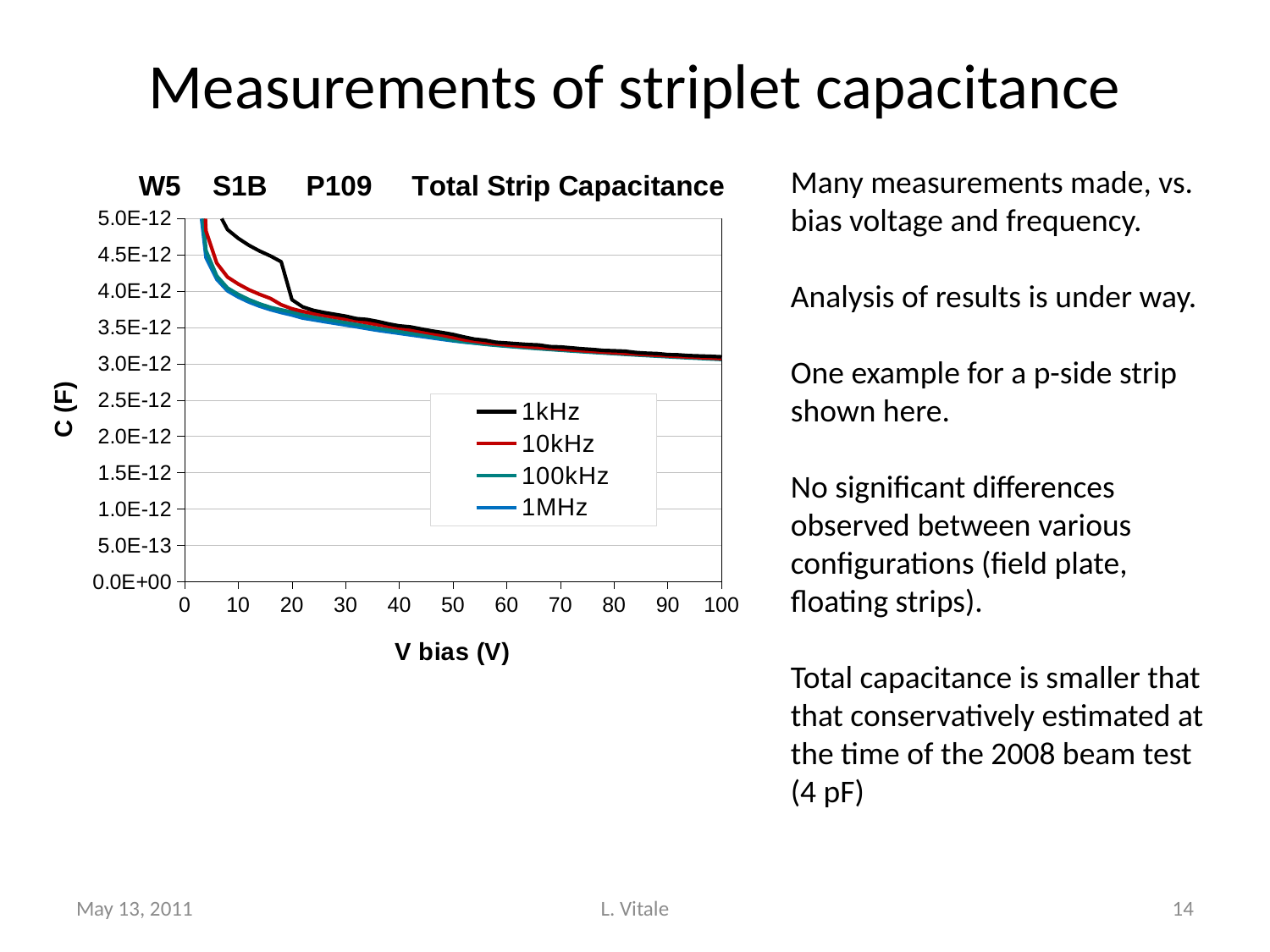
What is the label of the x axis of the chart? V bias (V) Which series are listed in the chart legend? 1kHz, 10kHz, 100kHz, 1MHz At a V bias of 10 V, which series has the highest capacitance value? 1kHz At a V bias of 100 V, is the value for the 1MHz series greater or less than 3.5E-12? less At a V bias of 15 V, which series has the larger value, 1kHz or 10kHz? 1kHz What is the maximum value shown on the y axis of the chart? 5.0E-12 How many series does the chart legend list? 4 At a V bias of 10 V, which series has the larger value, 1kHz or 1MHz? 1kHz At a V bias of 50 V, is the value for the 1kHz series greater or less than 4.0E-12? less Do the capacitance values rise or fall as V bias increases along the x axis? fall At a V bias of 10 V, is the value for the 1kHz series greater or less than 4.0E-12? greater What kind of chart is shown on the slide? line chart